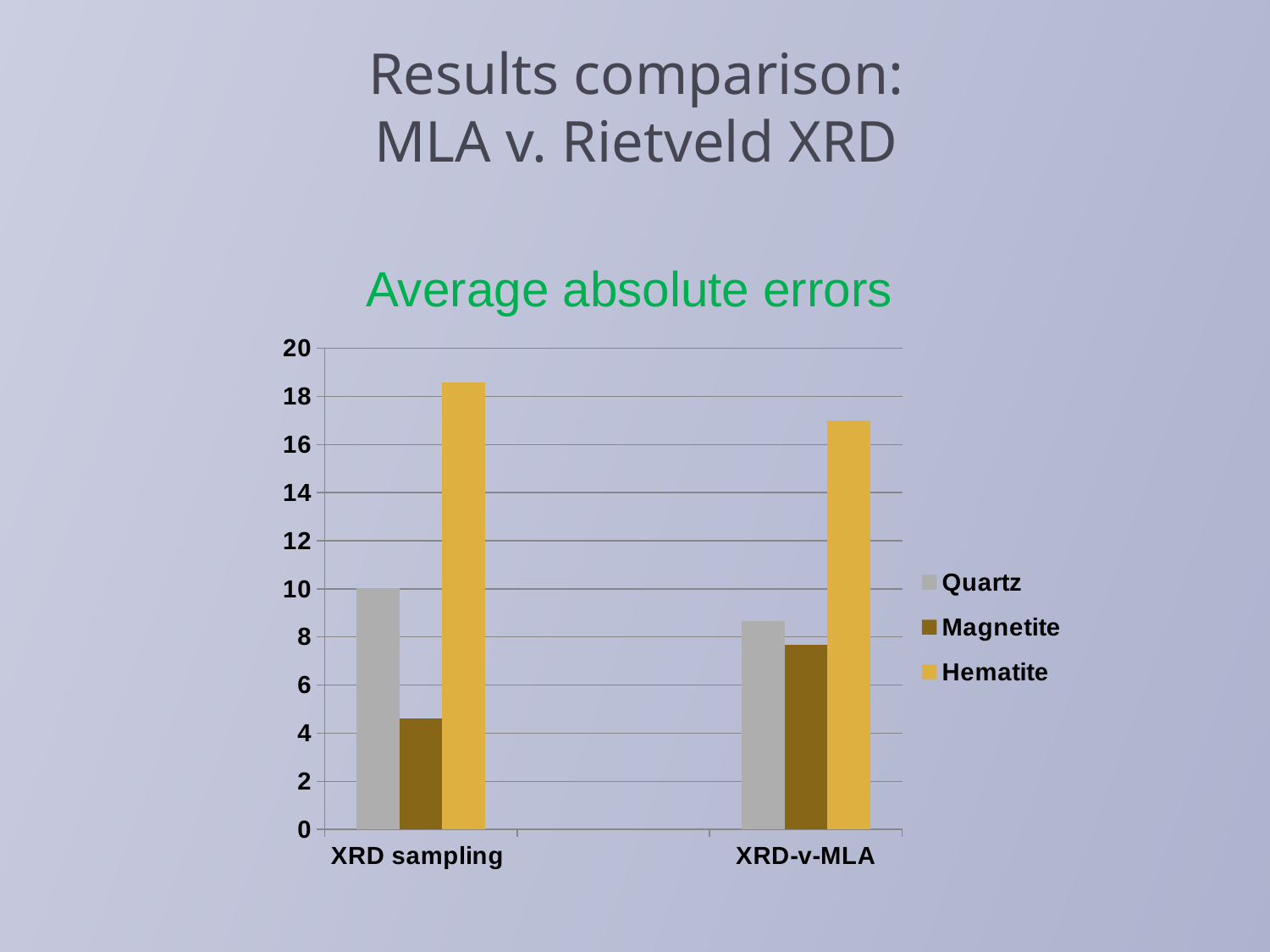
What colour are the Hematite bars in the "Average absolute errors" chart? yellow How many series does the legend of the "Average absolute errors" chart list? 3 Is the Hematite value for XRD sampling greater or less than 18? greater Is the Hematite value for XRD-v-MLA greater or less than 16? greater How many categories are shown on the x axis of the "Average absolute errors" chart? 2 Which series has the lowest value for XRD sampling? Magnetite Is the Magnetite value for XRD sampling greater or less than 6? less Is the Hematite value larger for XRD sampling or for XRD-v-MLA? XRD sampling Which series has the highest value for XRD sampling? Hematite Which series has the lowest value for XRD-v-MLA? Magnetite What kind of chart is shown under the title "Average absolute errors"? bar chart